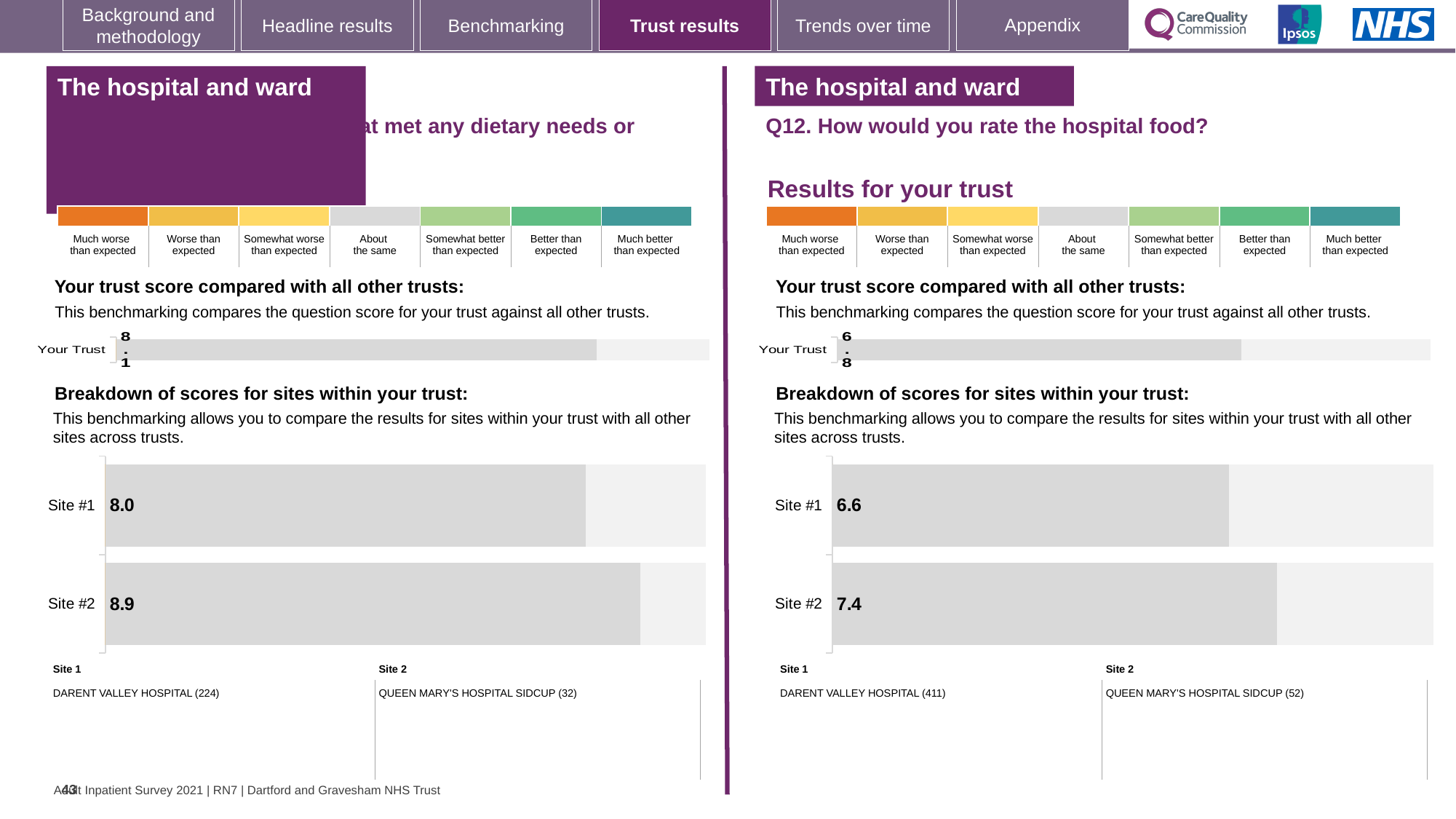
How many sites are shown in the right-hand site breakdown chart for Q12? 2 On the right-hand chart for Q12 (How would you rate the hospital food?), what is the score for Site #2? 7.4 On the left-hand site breakdown chart, what is the score for Site #2? 8.9 On the right-hand site breakdown chart for Q12, what is the difference between the Site #2 and Site #1 scores? 0.8 On the left-hand site breakdown chart, which site has the lower score? Site #1 On the left-hand 'Your trust score compared with all other trusts' chart, what is the score shown for Your Trust? 8.1 On the right-hand chart for Q12 (How would you rate the hospital food?), what is the score for Site #1? 6.6 On the right-hand 'Your trust score compared with all other trusts' chart for Q12, what is the score shown for Your Trust? 6.8 On the left-hand site breakdown chart, what is the difference between the Site #2 and Site #1 scores? 0.9 On the right-hand site breakdown chart for Q12, which site has the higher score? Site #2 On the left-hand site breakdown chart, what is the score for Site #1? 8.0 What type of chart is used for the site breakdown on the right-hand side of the slide? Bar chart